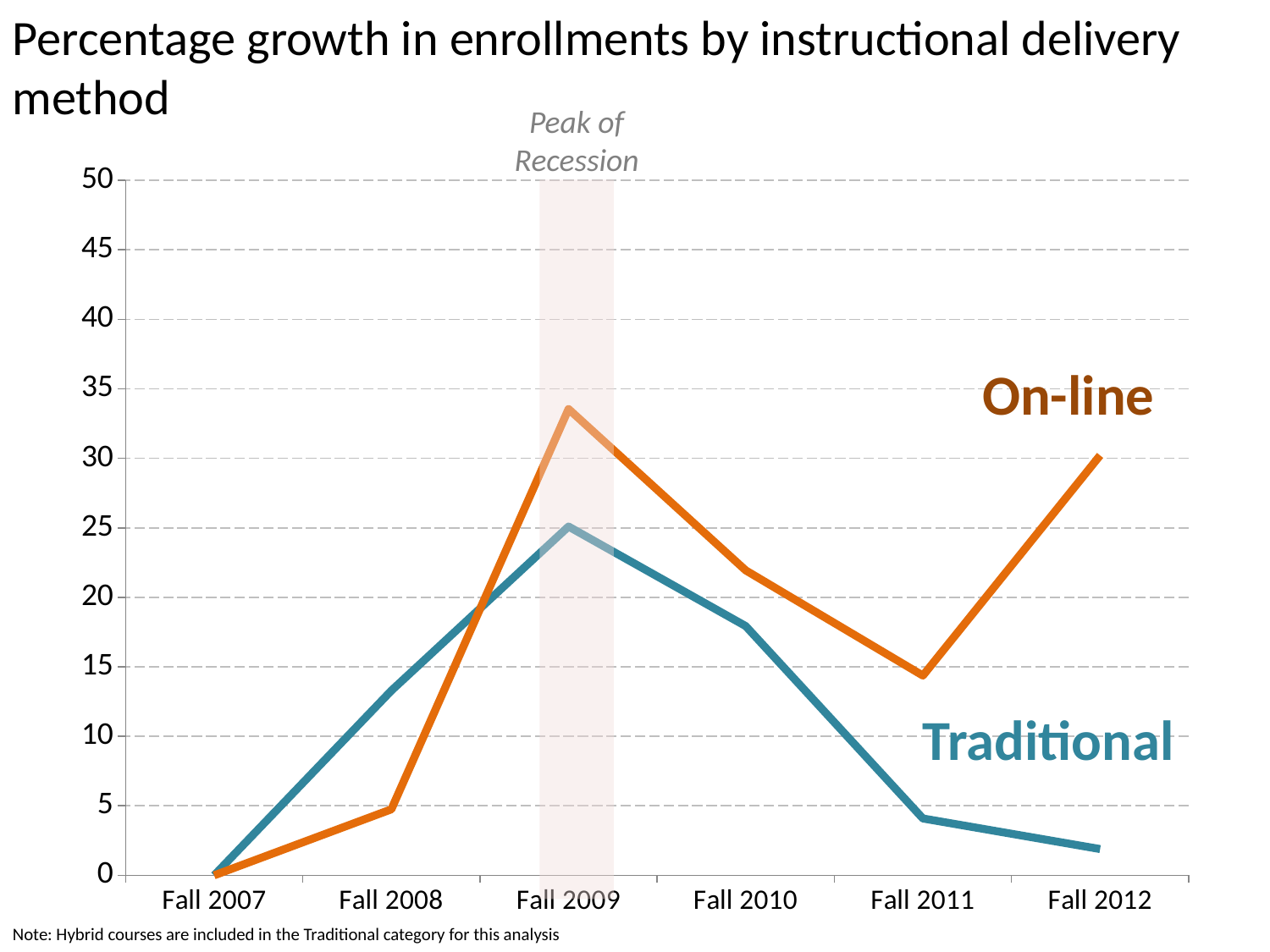
How many series are plotted on the chart? 2 In Fall 2008, which series has the larger value, On-line or Traditional? Traditional In which period is the Traditional series at its lowest value? Fall 2007 Is the Traditional value for Fall 2011 greater or less than 5? less How many time points are plotted along the x axis? 6 In which period does the Traditional series reach its highest value? Fall 2009 What label is given to the shaded vertical band on the chart? Peak of Recession What kind of chart is shown on the slide? line chart In which period does the On-line series reach its highest value? Fall 2009 Does the Traditional series rise or fall from Fall 2009 to Fall 2012? fall In Fall 2012, which series has the larger value, On-line or Traditional? On-line Is the On-line value for Fall 2009 greater or less than 30? greater